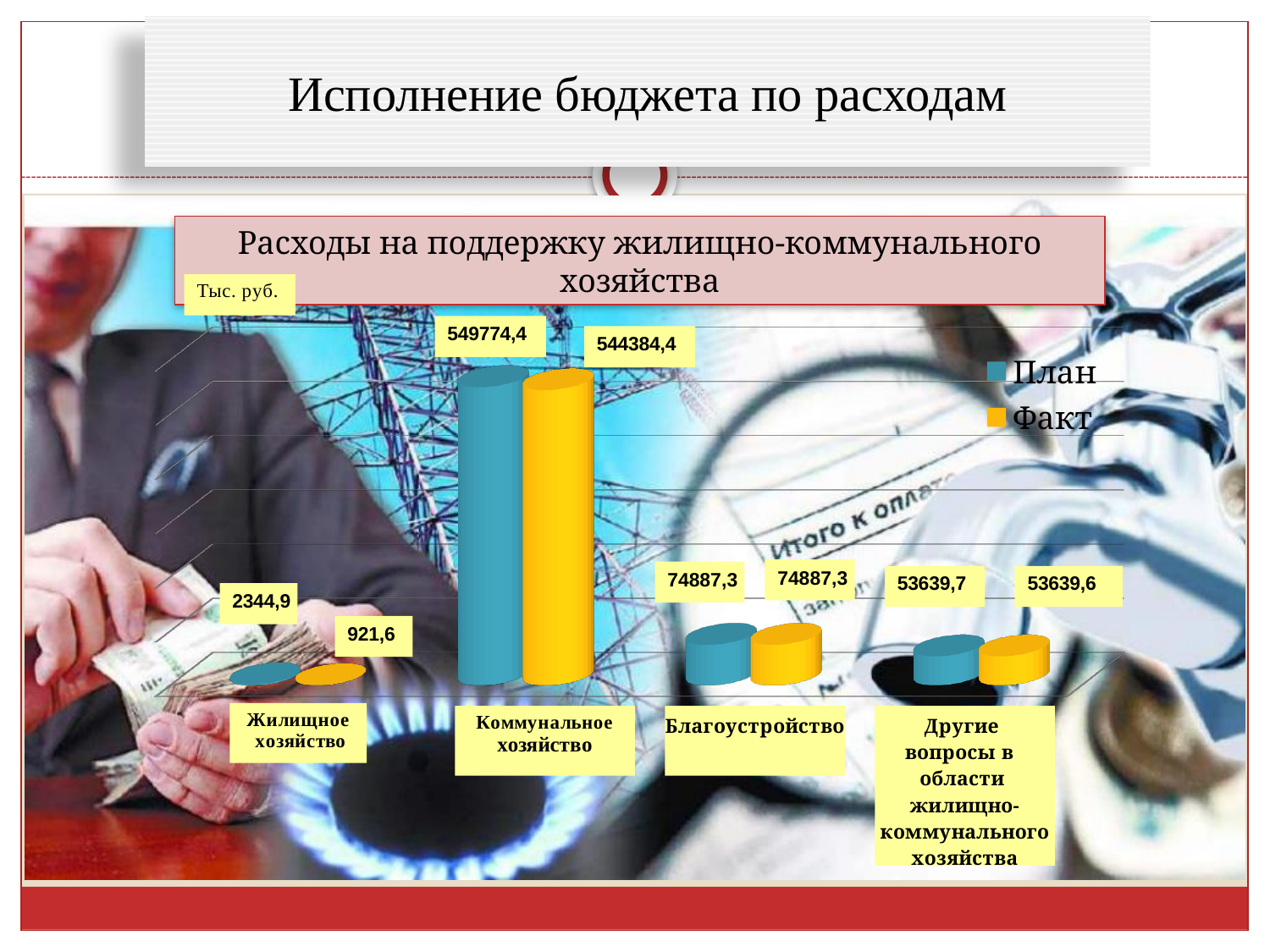
Which category has the lowest Факт value? Жилищное хозяйство What unit of measurement is indicated for the chart values? Тыс. руб. What is the difference between the План and Факт values for Жилищное хозяйство? 1423,3 What is the План value for Благоустройство? 74887,3 Which category has the highest План value? Коммунальное хозяйство What is the difference between the План and Факт values for Коммунальное хозяйство? 5390,0 How many categories are shown on the x axis of the chart? 4 How many series does the chart legend list? 2 What is the Факт value for Жилищное хозяйство? 921,6 What is the План value for Коммунальное хозяйство? 549774,4 What is the Факт value for Другие вопросы в области жилищно-коммунального хозяйства? 53639,6 Which is larger for Жилищное хозяйство, the План value or the Факт value? План